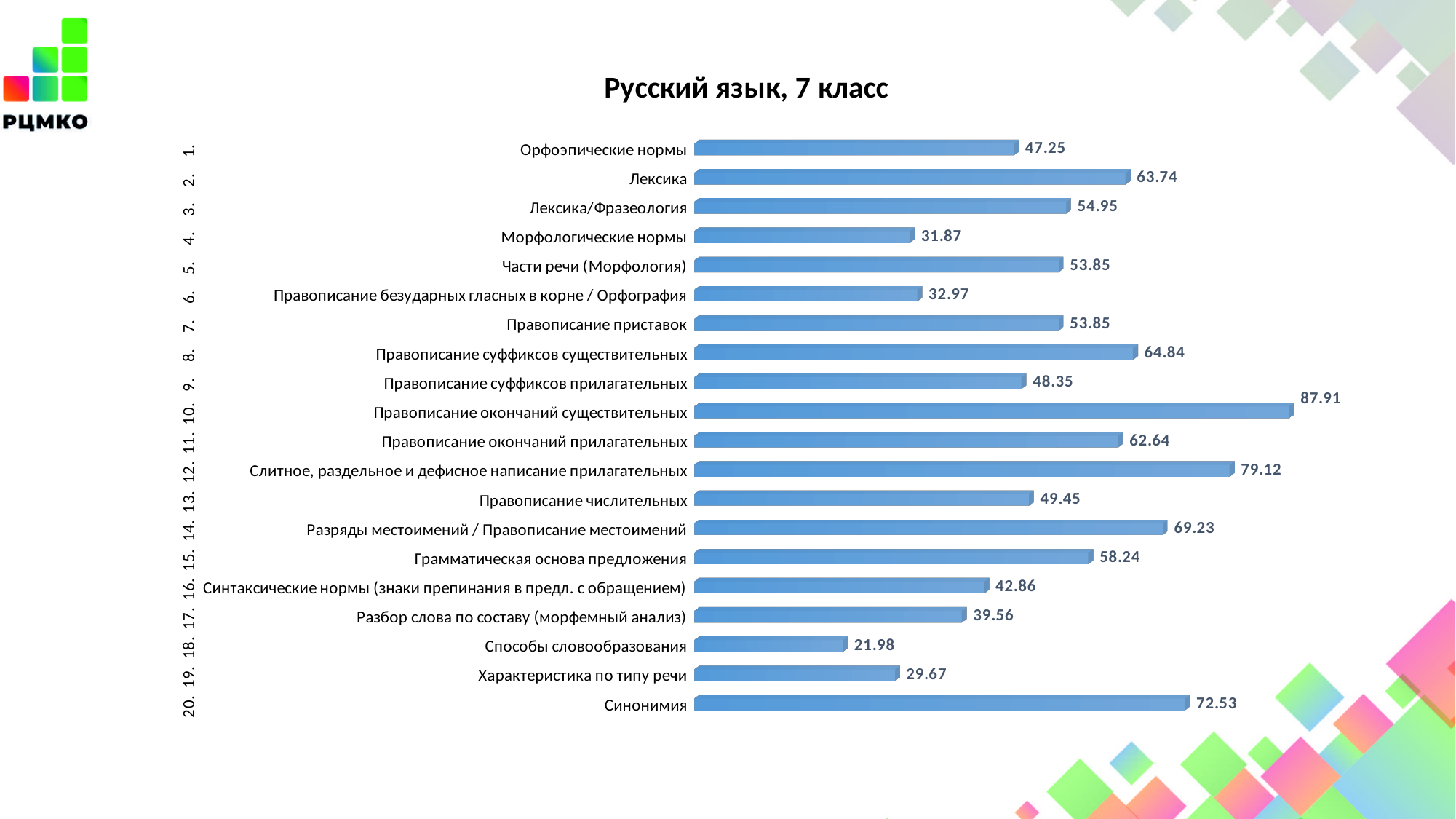
What is the value for Разряды местоимений / Правописание местоимений? 69.23 What is the value for Синонимия? 72.53 What is the difference between the values for Лексика and Морфологические нормы? 31.87 Which is larger, the value for Характеристика по типу речи or the value for Разбор слова по составу (морфемный анализ)? Разбор слова по составу (морфемный анализ) Which is larger, the value for Лексика/Фразеология or the value for Грамматическая основа предложения? Грамматическая основа предложения How many categories are shown in the chart? 20 Which category has the lowest value? Способы словообразования What is the difference between the values for Синонимия and Орфоэпические нормы? 25.28 Which category has the highest value? Правописание окончаний существительных What kind of chart is shown on the slide? Bar chart What is the value for Способы словообразования? 21.98 What is the value for Орфоэпические нормы? 47.25